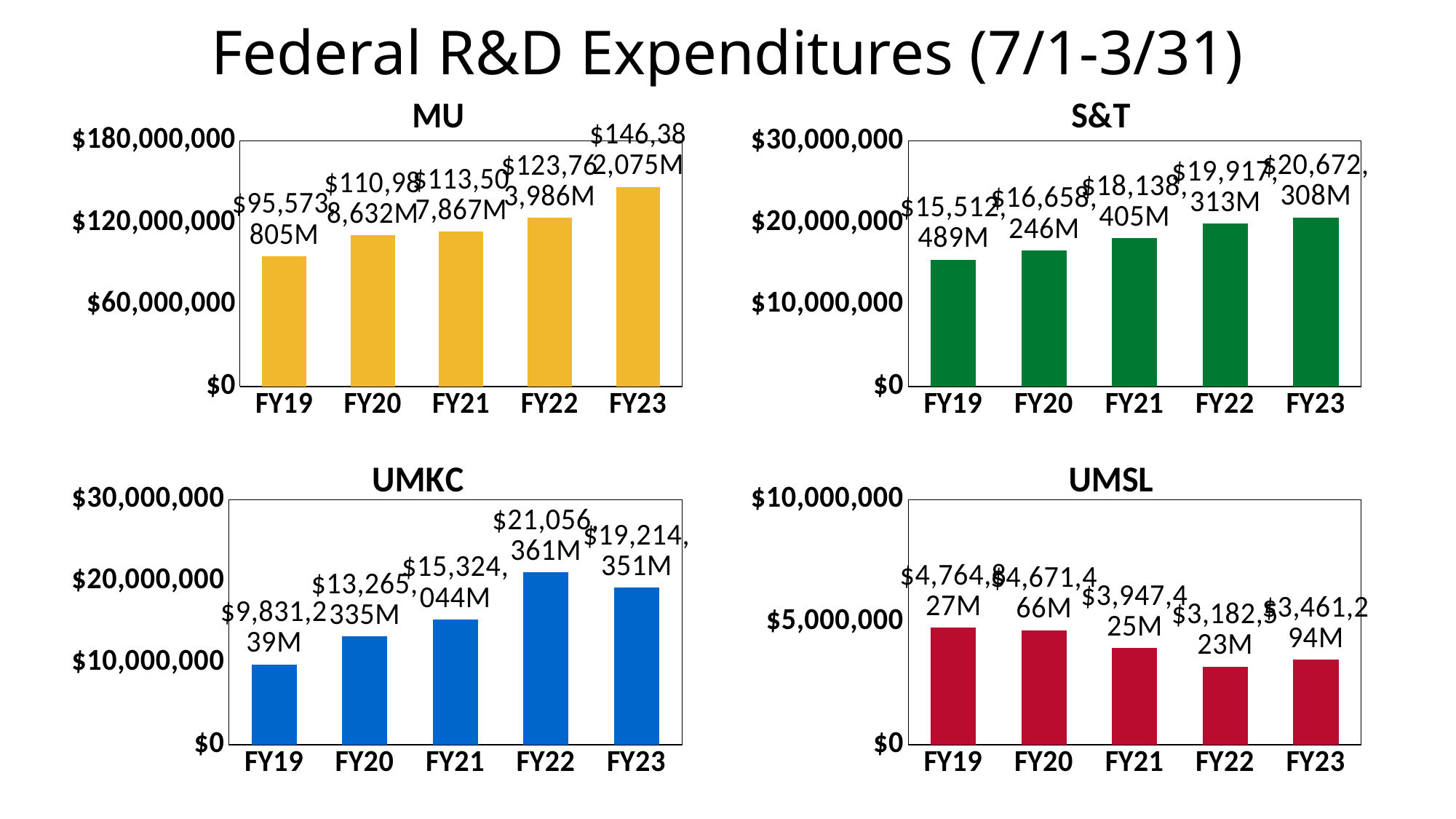
On the S&T chart, what is the value for FY23? $20,672,308M How many fiscal years are shown on the UMKC chart? 5 On the UMKC chart, which fiscal year has the lowest value? FY19 On the UMSL chart, what is the value for FY22? $3,182,523M On the UMSL chart, which fiscal year has the lowest value? FY22 On the MU chart, which fiscal year has the highest value? FY23 On the S&T chart, do the values rise or fall from FY19 to FY23? rise What kind of chart is the MU chart? bar chart On the MU chart, what is the value for FY19? $95,573,805M On the UMKC chart, what is the value for FY22? $21,056,361M On the UMKC chart, which is larger, the value for FY22 or the value for FY23? FY22 On the MU chart, is the value for FY23 greater or less than $120,000,000? greater